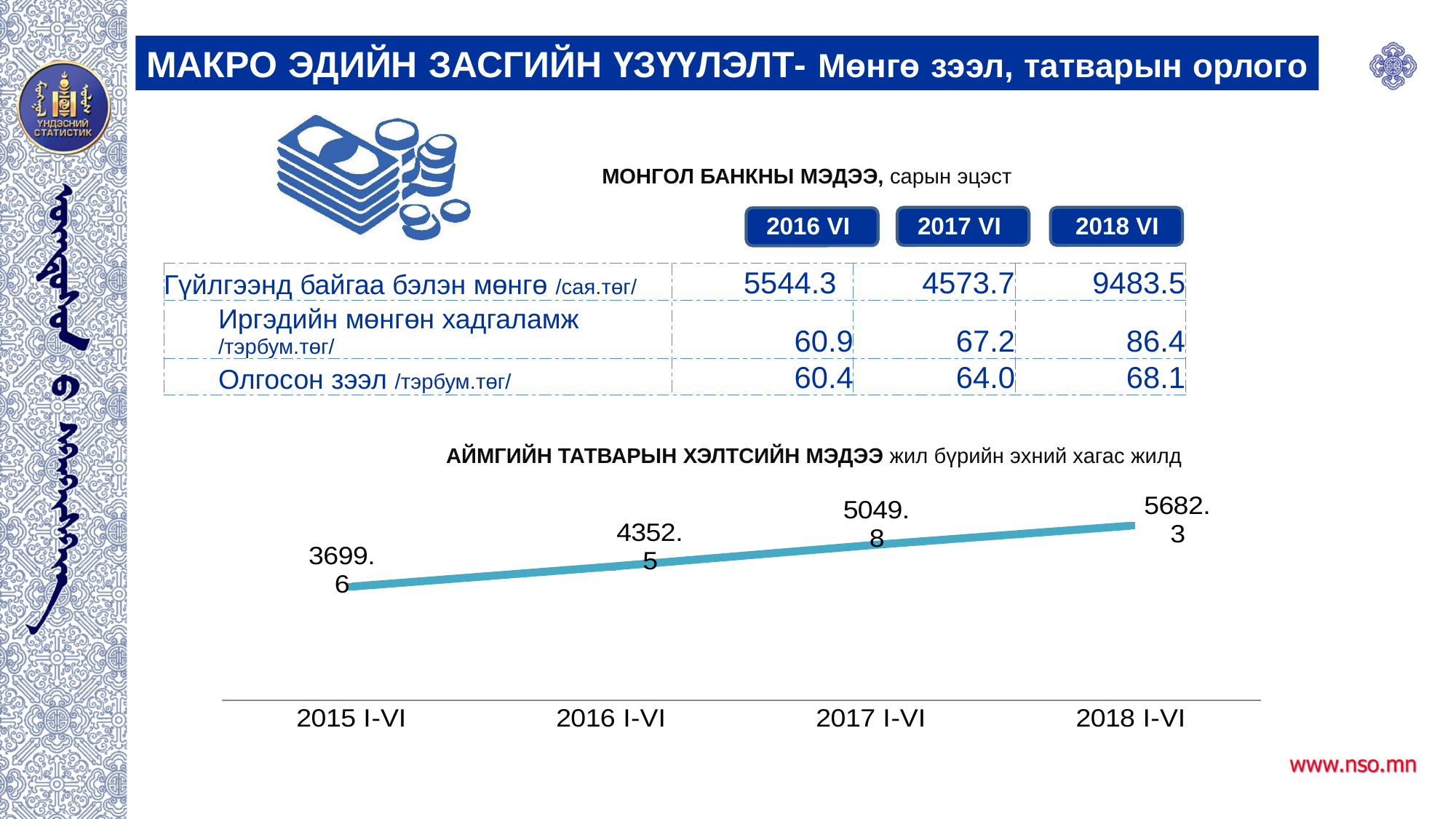
In the line chart, what is the value for 2015 I-VI? 3699.6 What type of chart is shown under the heading 'АЙМГИЙН ТАТВАРЫН ХЭЛТСИЙН МЭДЭЭ'? line chart In the line chart, which period has the highest value? 2018 I-VI In the line chart, what is the value for 2017 I-VI? 5049.8 How many data points are plotted in the line chart? 4 Do the values in the line chart rise or fall from 2015 I-VI to 2018 I-VI? rise In the line chart, what is the value for 2018 I-VI? 5682.3 In the line chart, what is the value for 2016 I-VI? 4352.5 In the line chart, which is larger: the value for 2016 I-VI or 2017 I-VI? 2017 I-VI In the line chart, what is the difference between the values for 2017 I-VI and 2016 I-VI? 697.3 In the line chart, what is the difference between the values for 2018 I-VI and 2015 I-VI? 1982.7 In the line chart, which period has the lowest value? 2015 I-VI